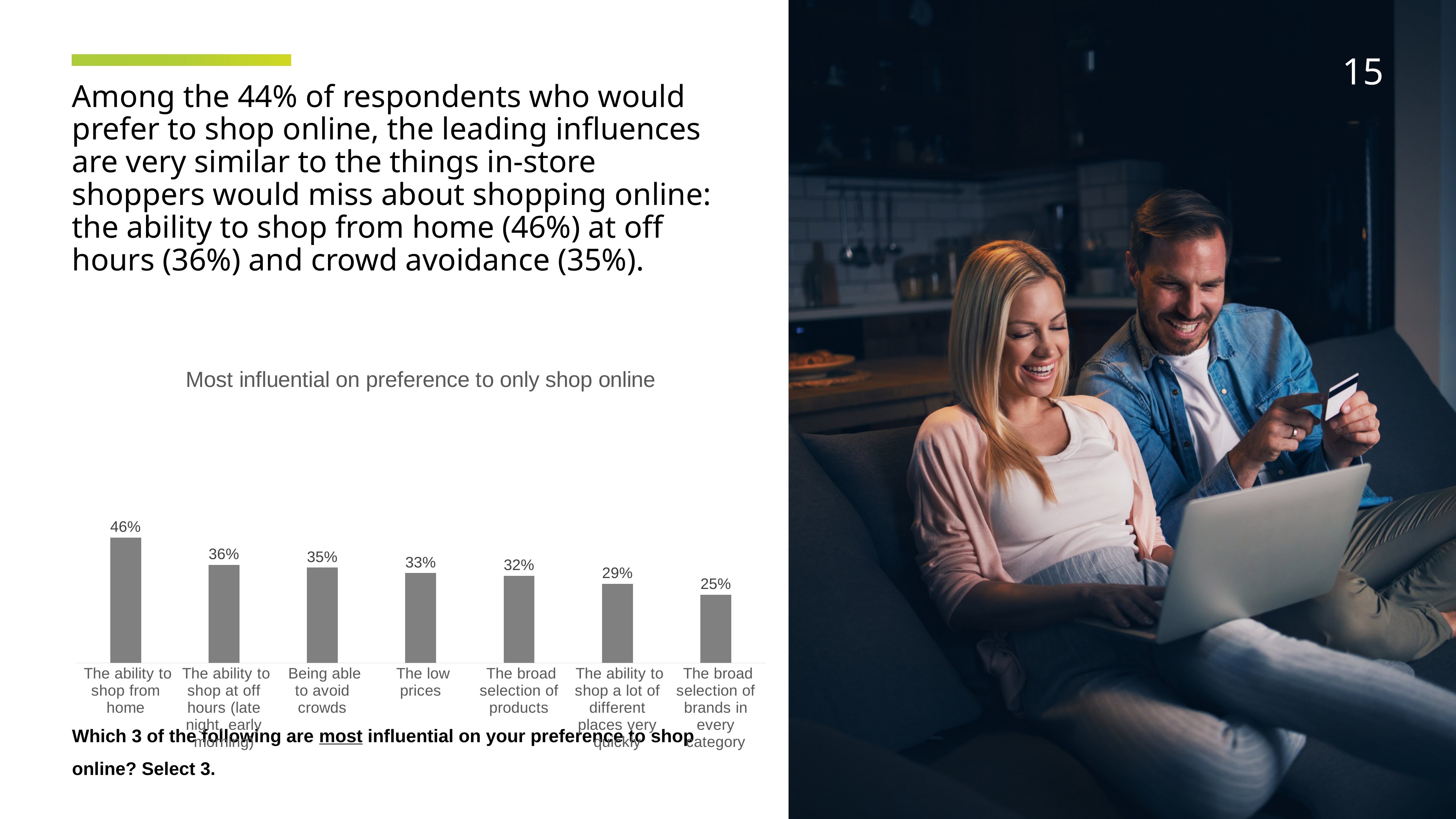
What is the value for 'Being able to avoid crowds'? 35% What kind of chart is shown? Bar chart What is the value for 'The low prices'? 33% Which category has the lowest value? The broad selection of brands in every category What is the difference between 'The ability to shop a lot of different places very quickly' and 'The broad selection of brands in every category'? 4% What is the title of the chart? Most influential on preference to only shop online What is the difference between 'The ability to shop from home' and 'The ability to shop at off hours (late night, early morning)'? 10% What is the value for 'The broad selection of products'? 32% Which category has the highest value? The ability to shop from home How many categories are shown in the chart? 7 What is the value for 'The ability to shop from home'? 46% Which is larger: 'The low prices' or 'The broad selection of products'? The low prices